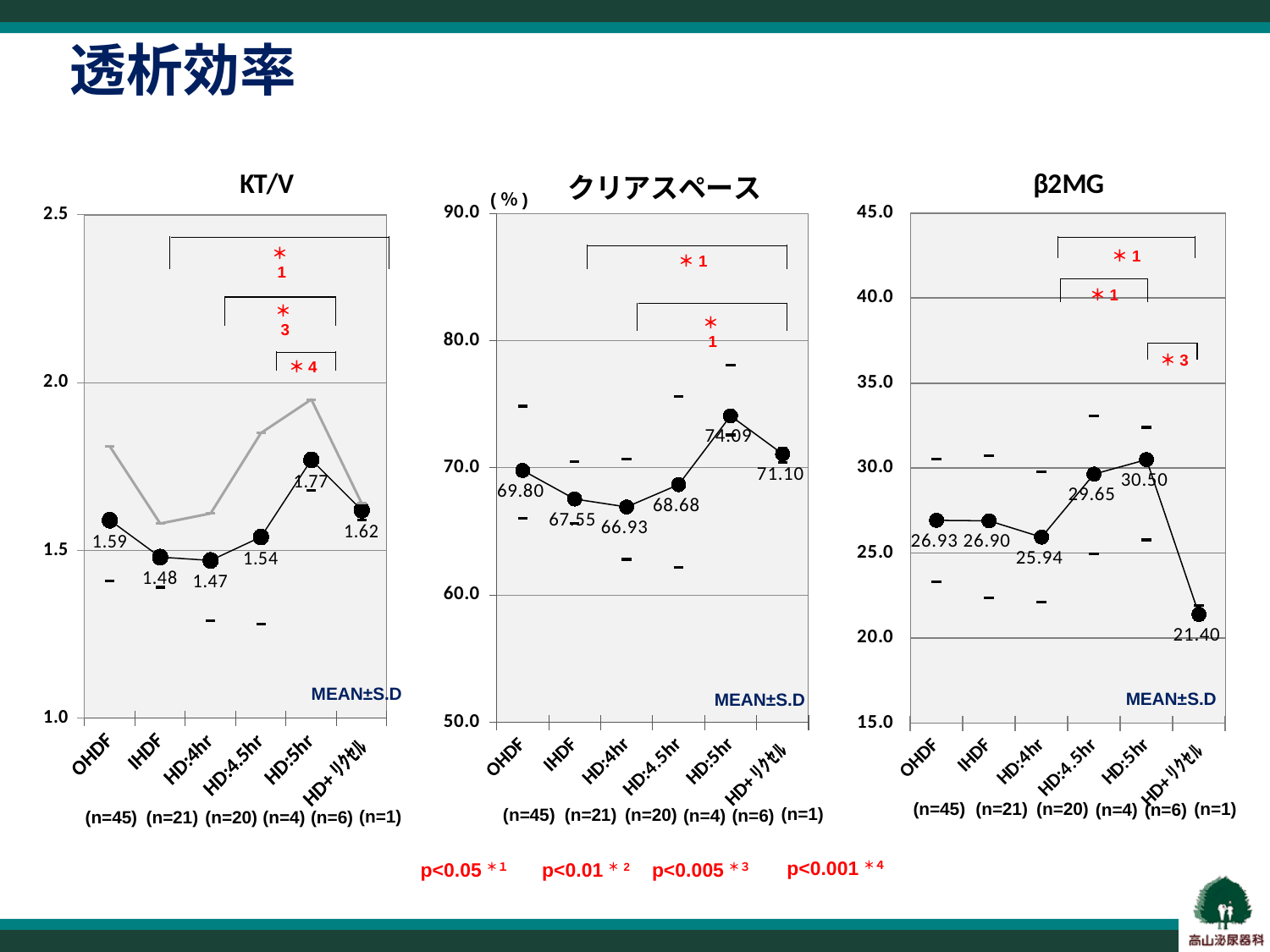
In the クリアスペース chart, is the value for HD:4hr greater or less than 70.0? less In the β2MG chart, which category has the lowest value? HD+リクセル In the β2MG chart, which is larger, the value for HD:4.5hr or the value for HD:4hr? HD:4.5hr In the β2MG chart, what is the difference between the values for HD:5hr and HD+リクセル? 9.10 In the クリアスペース chart, what is the value for OHDF? 69.80 How many categories are plotted on the x axis of the KT/V chart? 6 In the KT/V chart, what is the value for HD:5hr? 1.77 In the KT/V chart, what is the difference between the values for HD:5hr and HD:4hr? 0.30 In the クリアスペース chart, which category has the highest value? HD:5hr In the β2MG chart, what is the value for HD+リクセル? 21.40 What kind of chart is the クリアスペース chart? line chart In the KT/V chart, which category has the lowest value? HD:4hr